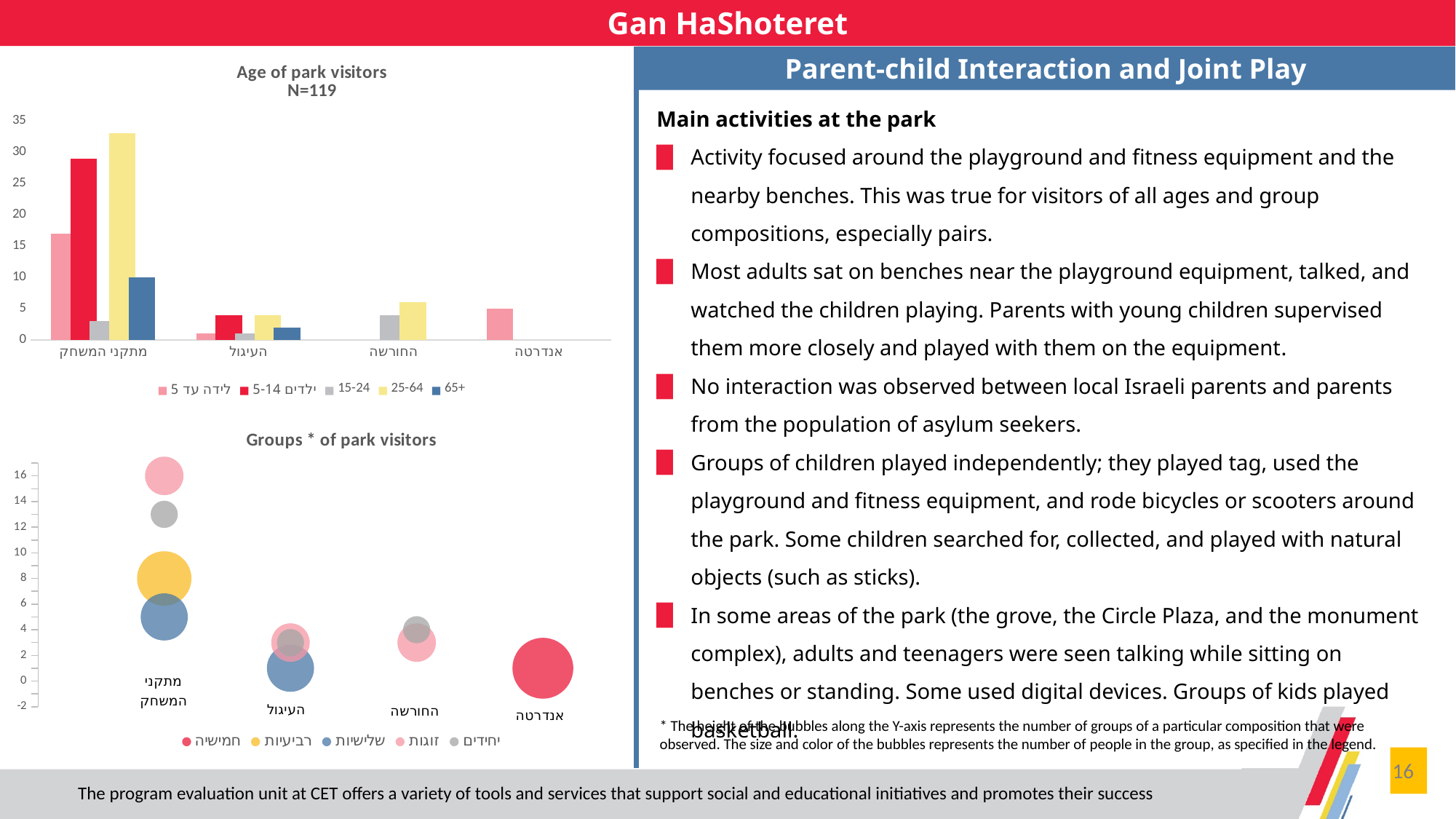
In the 'Groups * of park visitors' chart, which category has the highest-placed bubble? מתקני המשחק How many series does the legend of the 'Age of park visitors' chart list? 5 In the 'Age of park visitors' chart, which is larger at מתקני המשחק: the 65+ bar or the 15-24 bar? 65+ In the 'Groups * of park visitors' chart, is the value for זוגות at מתקני המשחק greater or less than 14? greater What is the N value shown in the title of the 'Age of park visitors' chart? N=119 How many series does the legend of the 'Groups * of park visitors' chart list? 5 In the 'Groups * of park visitors' chart, is the value for חמישיה at אנדרטה greater or less than 4? less In the 'Age of park visitors' chart, is the value for 25-64 at מתקני המשחק greater or less than 30? greater What kind of chart is the 'Age of park visitors' chart? bar chart In the 'Age of park visitors' chart, which age group has the tallest bar for מתקני המשחק? 25-64 How many categories are shown on the x axis of the 'Age of park visitors' chart? 4